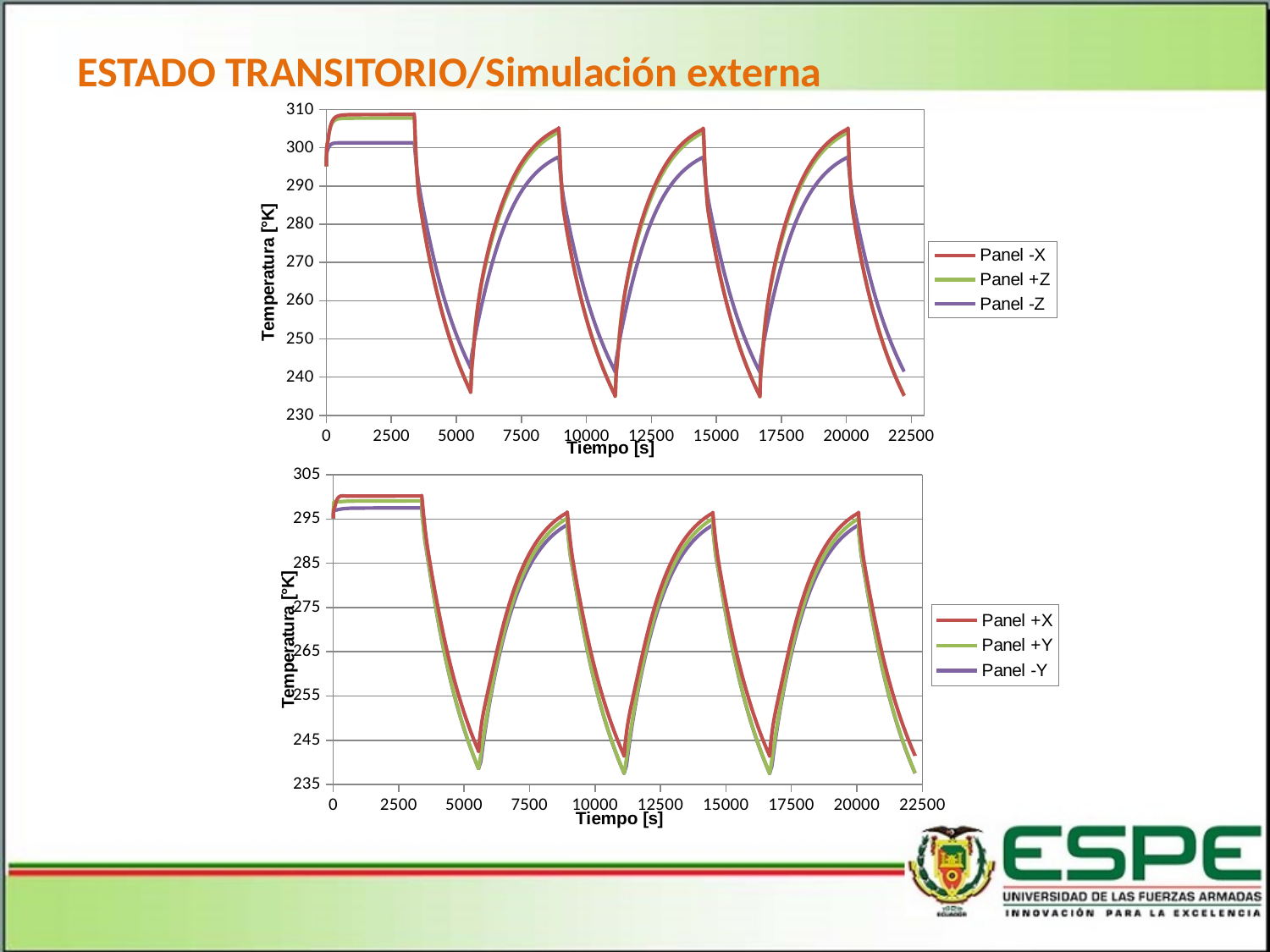
In the top chart, is the initial plateau value of Panel -Z greater or less than 305? less In the bottom chart, what is the label of the x axis? Tiempo [s] What kind of chart is the top chart on the slide? line chart How many series does the legend of the bottom chart list? 3 In the bottom chart, is the initial plateau value of Panel +X greater or less than 295? greater In the top chart, are the later peaks of Panel -Z (after the first plateau) greater or less than 300? less In the top chart, during the initial plateau, which series is higher: Panel -X or Panel -Z? Panel -X In the top chart, which series are listed in the legend? Panel -X, Panel +Z, Panel -Z How many series does the legend of the top chart list? 3